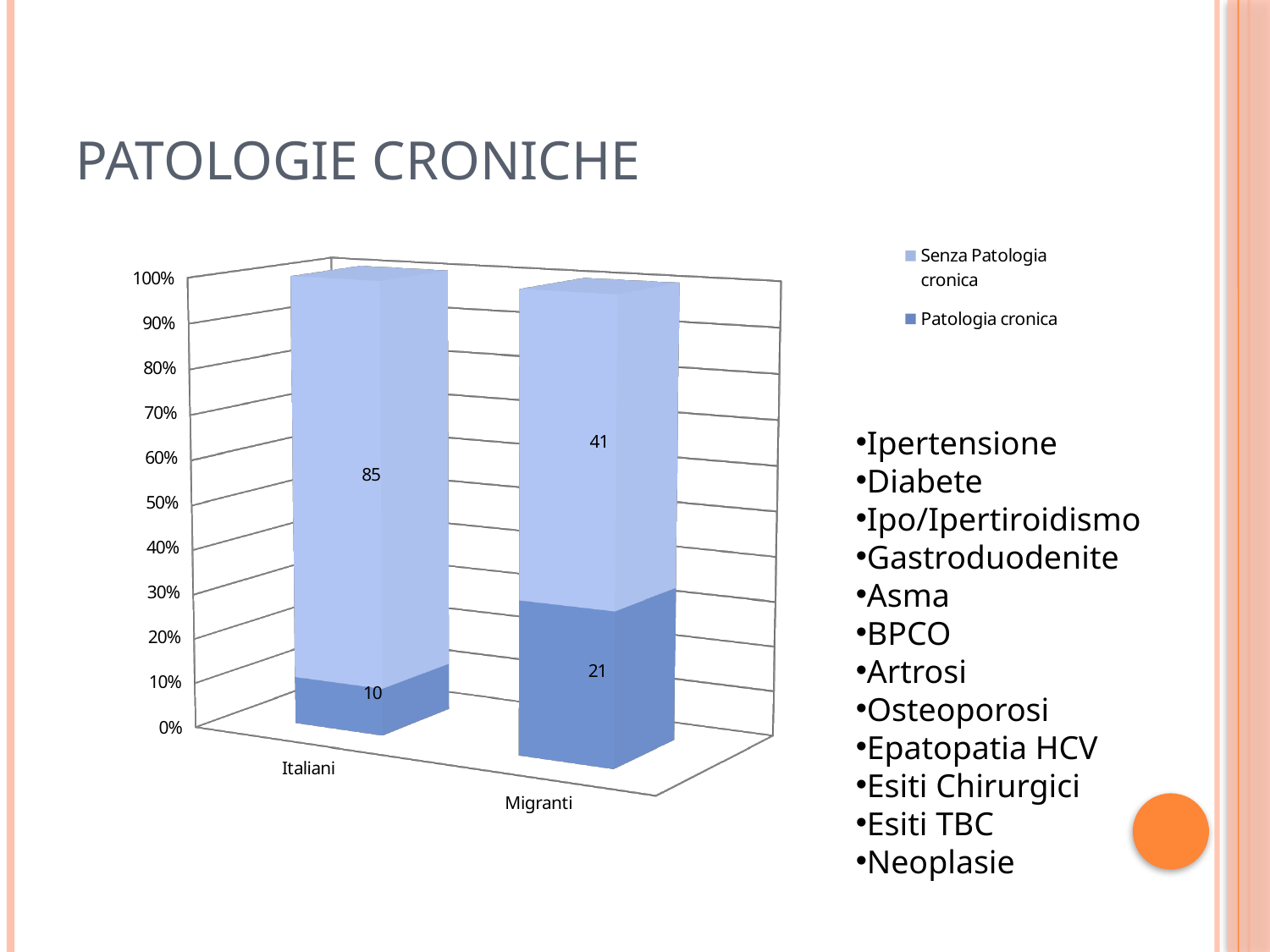
What is the data label for Senza Patologia cronica in the Italiani bar? 85 What is the data label for Patologia cronica in the Migranti bar? 21 What kind of chart is shown on the slide? Stacked bar chart What is the sum of the two data labels in the Migranti bar? 62 What is the sum of the two data labels in the Italiani bar? 95 How many categories are shown on the x axis? 2 What is the data label for Senza Patologia cronica in the Migranti bar? 41 Which category has the larger Patologia cronica label, Italiani or Migranti? Migranti What is the difference between the Senza Patologia cronica labels for Italiani and Migranti? 44 How many series does the legend list? 2 Which category has the larger Senza Patologia cronica label, Italiani or Migranti? Italiani What is the data label for Patologia cronica in the Italiani bar? 10